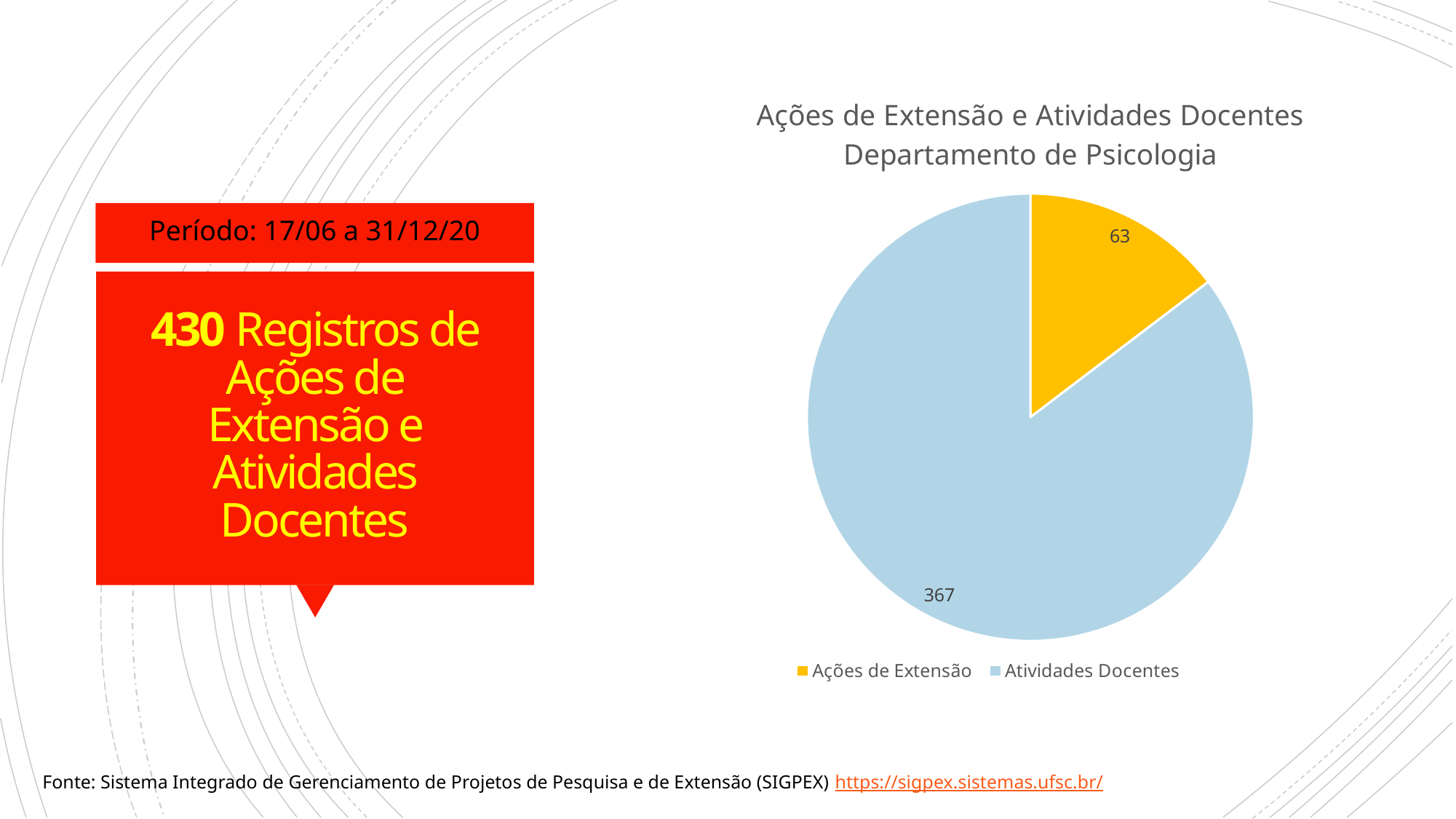
What is the value for Ações de Extensão? 63 What is the value for Atividades Docentes? 367 How many categories does the pie chart show? 2 What is the difference between the values for Atividades Docentes and Ações de Extensão? 304 What type of chart is shown on the slide? pie chart Which is larger, Ações de Extensão or Atividades Docentes? Atividades Docentes Which category has the smallest slice of the pie? Ações de Extensão What colour is the slice for Ações de Extensão? yellow How many entries does the legend list? 2 Which category has the largest slice of the pie? Atividades Docentes What is the total of the two slices in the pie chart? 430 What is the title of the chart? Ações de Extensão e Atividades Docentes Departamento de Psicologia